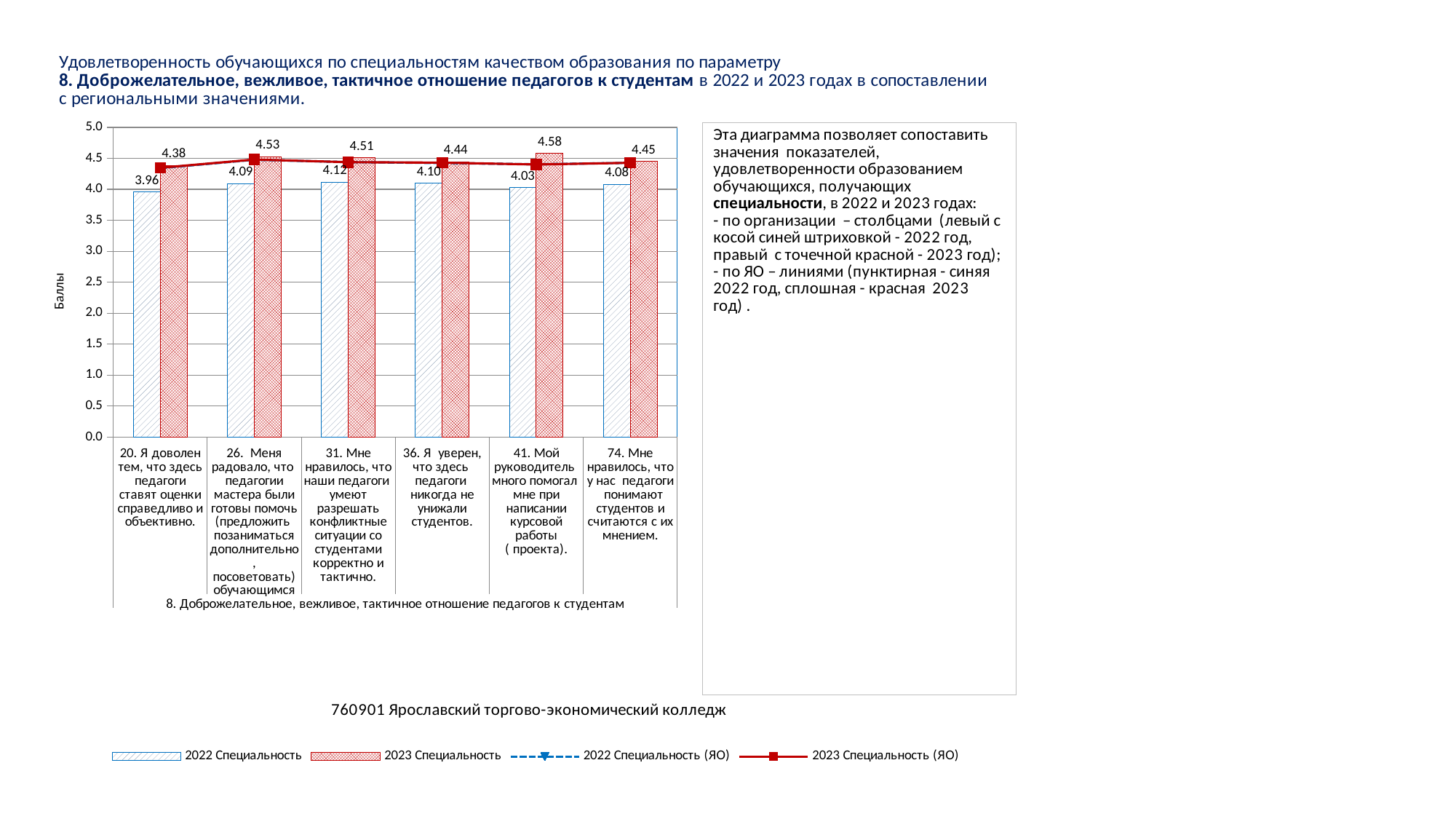
How many survey items (categories) are shown on the x axis? 6 How many series does the legend list? 4 What is the 2023 Специальность value for item 41 (Мой руководитель много помогал мне при написании курсовой работы)? 4.58 Which item has the lowest 2022 Специальность value? 20. Я доволен тем, что здесь педагоги ставят оценки справедливо и объективно. What is the 2022 Специальность value for item 20 (Я доволен тем, что здесь педагоги ставят оценки справедливо и объективно)? 3.96 Which is larger for item 74: the 2022 Специальность value or the 2023 Специальность value? 2023 Специальность (4.45) What kind of chart is shown on the slide? A combined bar and line chart What is the difference between the 2023 and 2022 Специальность values for item 41? 0.55 What is the label of the vertical axis? Баллы Is the 2022 Специальность value for item 31 greater or less than 4.5? less Which item has the highest 2023 Специальность value? 41. Мой руководитель много помогал мне при написании курсовой работы (проекта). What is the 2023 Специальность value for item 26 (Меня радовало, что педагоги мастера были готовы помочь)? 4.53